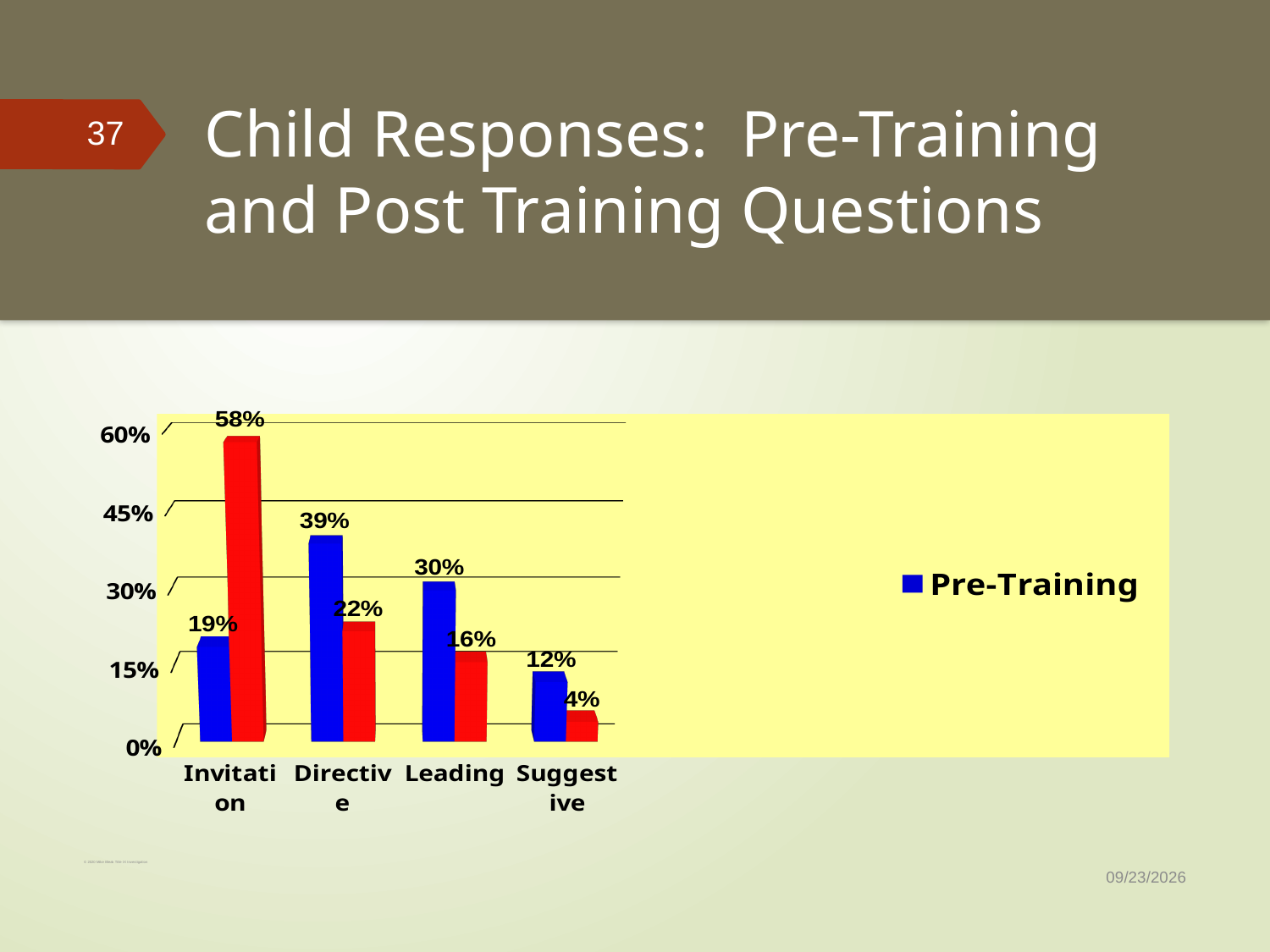
What is the difference between the red bar and the Pre-Training bar for Invitation? 39% What is the value of the red bar for Invitation? 58% What is the value of the red bar for Suggestive? 4% How many categories are shown on the x axis? 4 What is the Pre-Training value for Invitation? 19% Which category has the highest Pre-Training value? Directive What kind of chart is shown on the slide? Bar chart What is the difference between the Pre-Training values for Directive and Leading? 9% Which is larger for Leading: the Pre-Training bar or the red bar? Pre-Training How many series does the legend list? 1 What is the Pre-Training value for Directive? 39% Which category has the lowest Pre-Training value? Suggestive